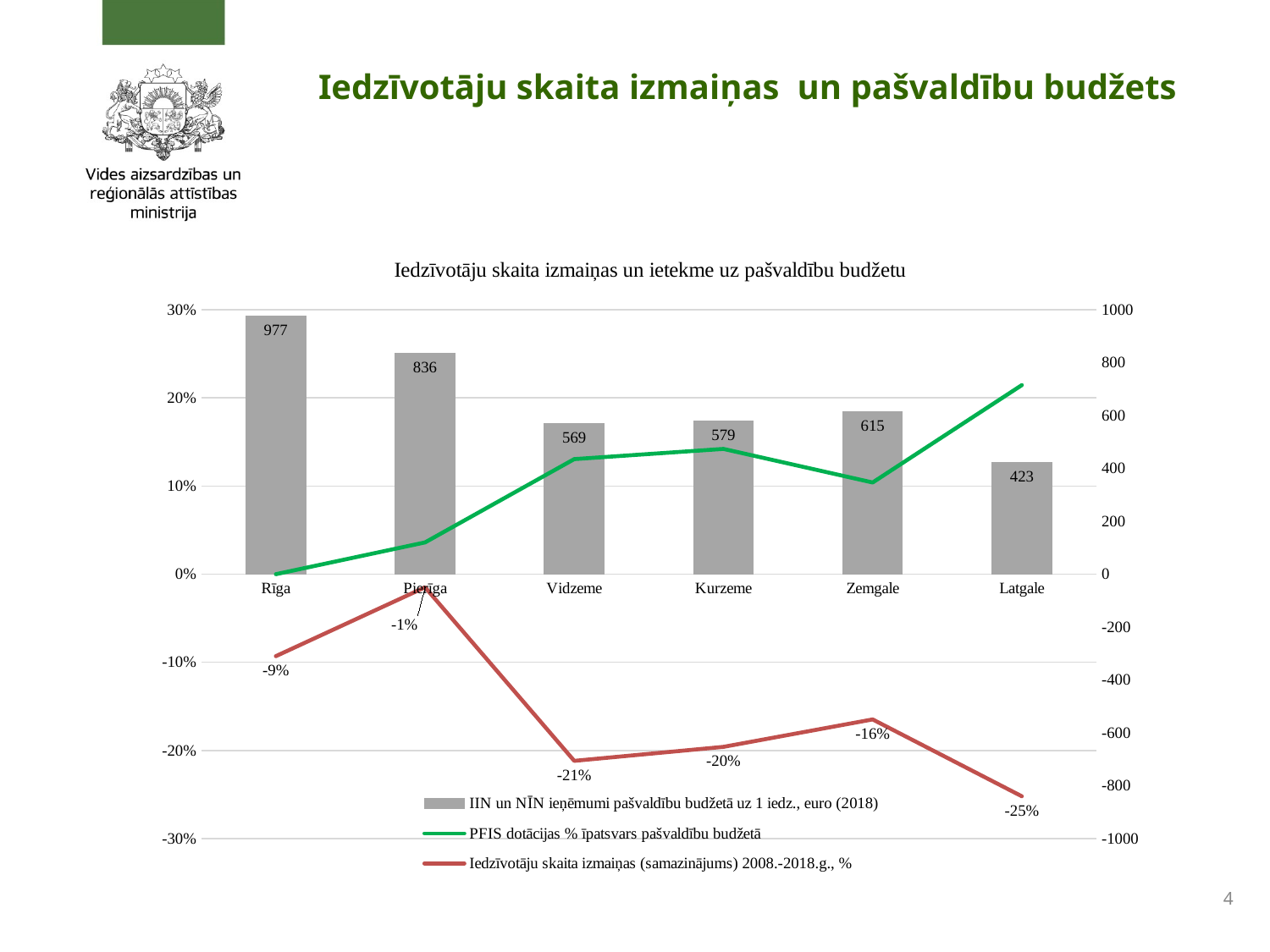
Is the PFIS dotācijas % value for Vidzeme greater or less than 10%? greater Which has a larger IIN un NĪN ieņēmumi bar, Kurzeme or Vidzeme? Kurzeme Which region has the lowest Iedzīvotāju skaita izmaiņas value? Latgale Which region has the highest IIN un NĪN ieņēmumi bar? Rīga What is the value of the IIN un NĪN ieņēmumi bar for Rīga? 977 How many regions are shown on the x axis? 6 What is the Iedzīvotāju skaita izmaiņas value for Pierīga? -1% What is the value of the IIN un NĪN ieņēmumi bar for Latgale? 423 Which region has the lowest IIN un NĪN ieņēmumi bar? Latgale How many series does the legend list? 3 What is the Iedzīvotāju skaita izmaiņas value for Latgale? -25% What is the difference between the IIN un NĪN ieņēmumi bars for Rīga and Pierīga? 141